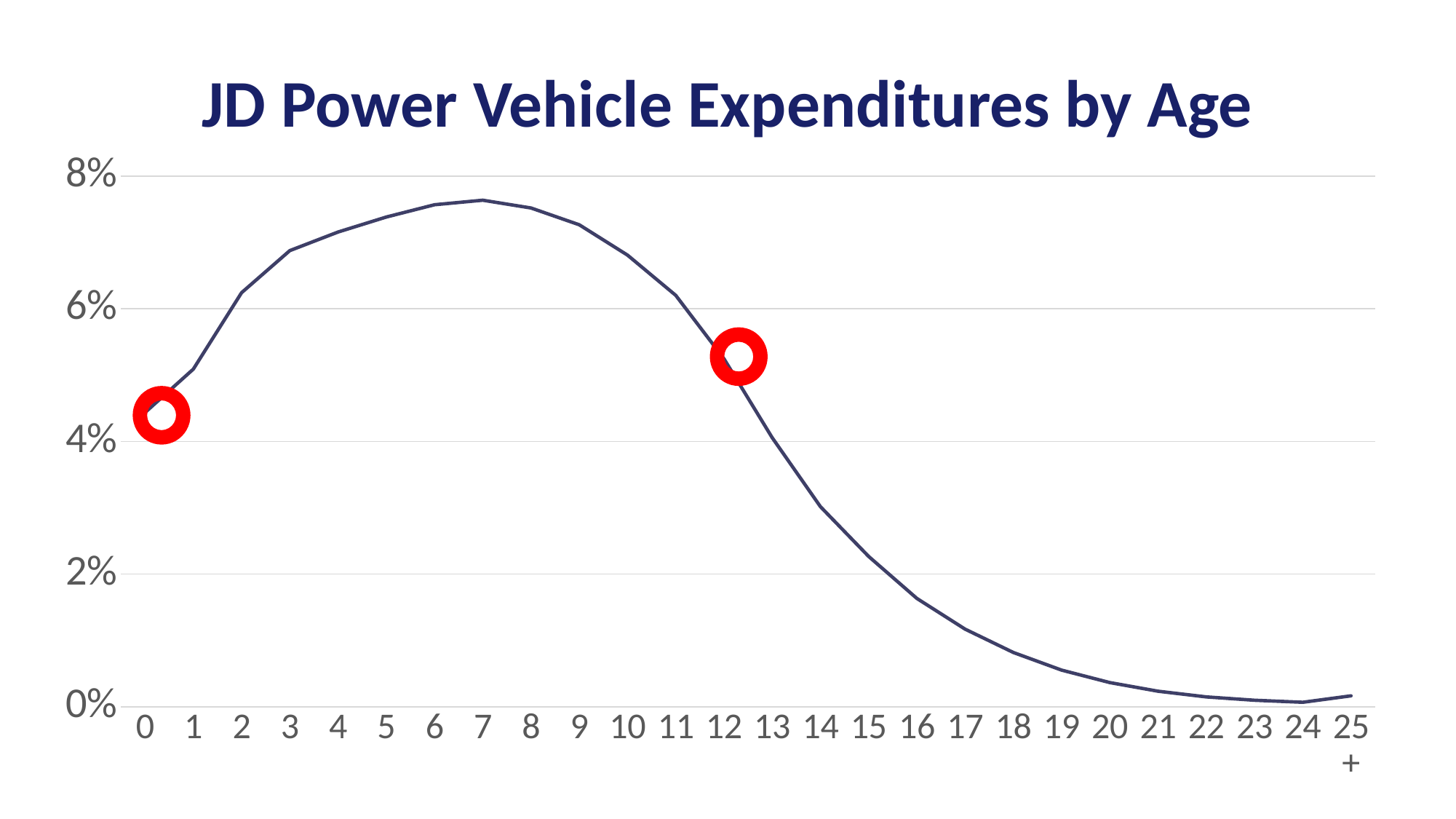
What is the title of the chart? JD Power Vehicle Expenditures by Age How many age categories are shown on the x axis? 26 Is the value for age 0 greater or less than 4%? greater Is the value for age 7 greater or less than 8%? less Is the value for age 16 greater or less than 2%? less What kind of chart is shown on the slide? line chart Which has the larger value, age 3 or age 12? age 3 At which age does the line reach its highest value? 7 Do the values rise or fall along the x axis from age 7 to age 24? fall Which two ages are marked with red circles on the line? 0 and 12